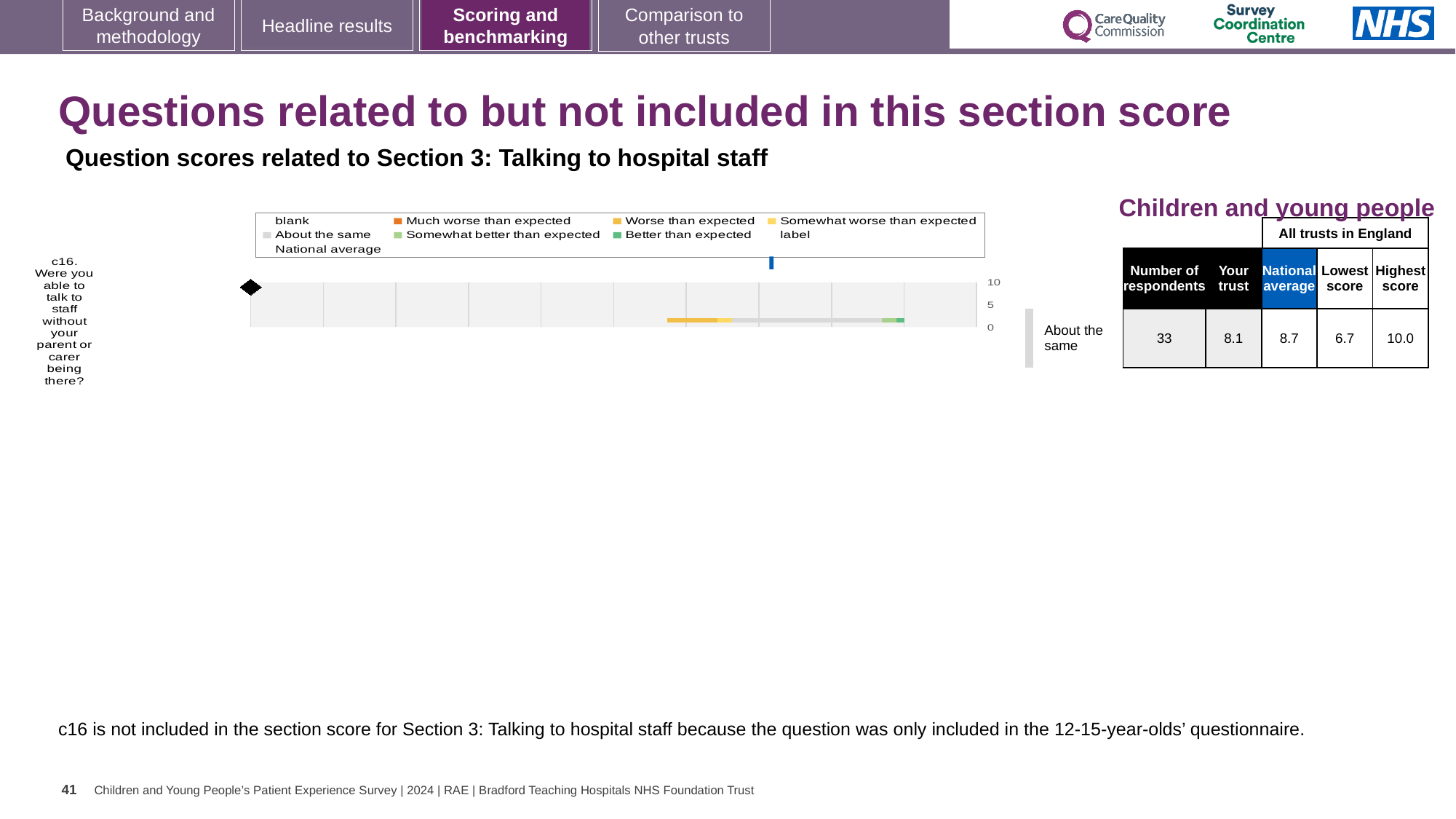
What is the highest value shown on the chart's score axis? 10 Which legend entry is shown in orange? Much worse than expected What is the difference between the national average (8.7) and the 'Your trust' score (8.1) for c16? 0.6 What kind of chart is used to show the c16 question score? bar chart Which is larger for c16: the 'Your trust' score or the national average? National average According to the table beside the chart, how many respondents answered c16? 33 According to the table beside the chart, what is the highest score among all trusts in England for c16? 10.0 How many survey questions are plotted on the chart? 1 According to the table beside the chart, what is the 'Your trust' score for c16? 8.1 Is the 'Your trust' score for c16 greater or less than 5? greater According to the table beside the chart, what is the national average score for c16? 8.7 According to the table beside the chart, what is the lowest score among all trusts in England for c16? 6.7